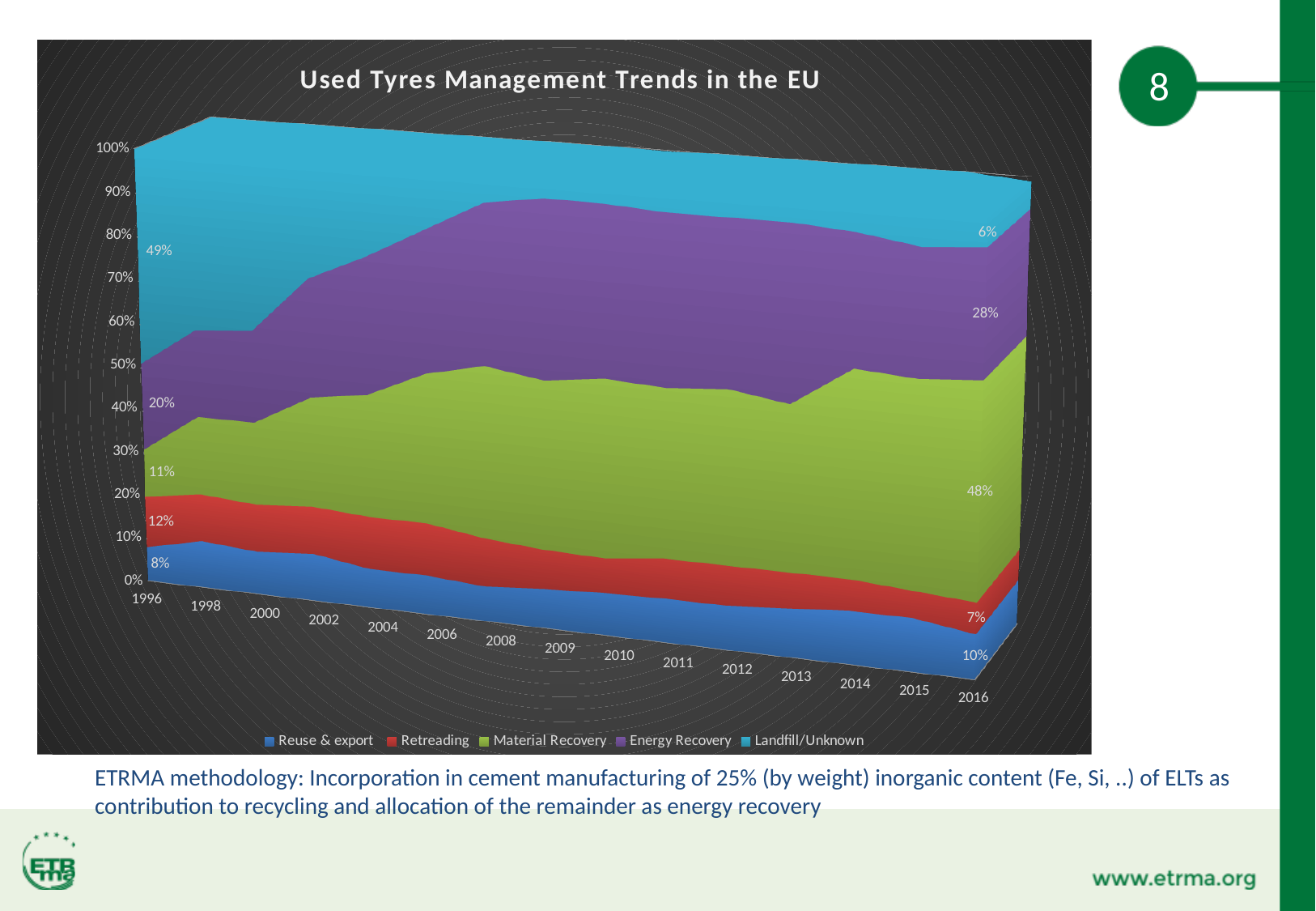
What kind of chart is shown on the slide? Stacked area chart What is the difference between the Material Recovery value in 2016 and in 1996? 37% How many series does the legend list? 5 Which series has the lowest value in 2016? Landfill/Unknown What is the value for Material Recovery in 2016? 48% Does the Landfill/Unknown share rise or fall from 1996 to 2016? Fall What is the value for Retreading in 1996? 12% What is the value for Reuse & export in 2016? 10% Which series has the highest value in 1996? Landfill/Unknown What is the title of the chart? Used Tyres Management Trends in the EU What is the value for Landfill/Unknown in 1996? 49% What is the value for Energy Recovery in 2016? 28%